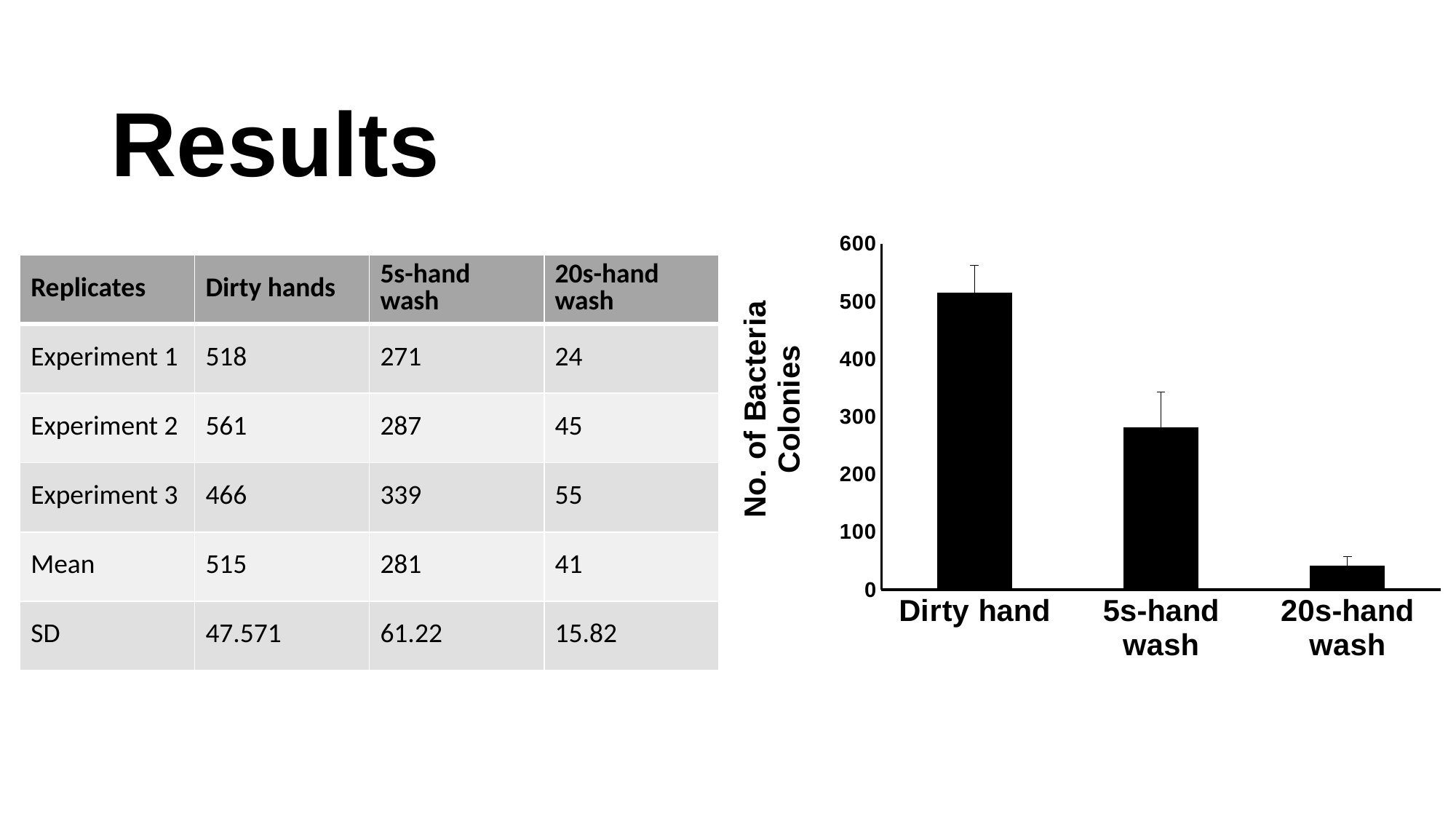
Which is larger, the bar for 5s-hand wash or the bar for 20s-hand wash? 5s-hand wash Is the value for 5s-hand wash greater or less than 300? less How many categories are plotted on the x axis of the chart? 3 Is the value for Dirty hand greater or less than 500? greater Do the bar values rise or fall from left to right along the x axis? fall What kind of chart is shown on the slide? bar chart Which category has the lowest bar in the chart? 20s-hand wash Is the value for 20s-hand wash greater or less than 100? less Which is larger, the bar for Dirty hand or the bar for 5s-hand wash? Dirty hand What is the highest tick value shown on the y axis of the chart? 600 Which category has the highest bar in the chart? Dirty hand What is the label of the y axis of the chart? No. of Bacteria Colonies